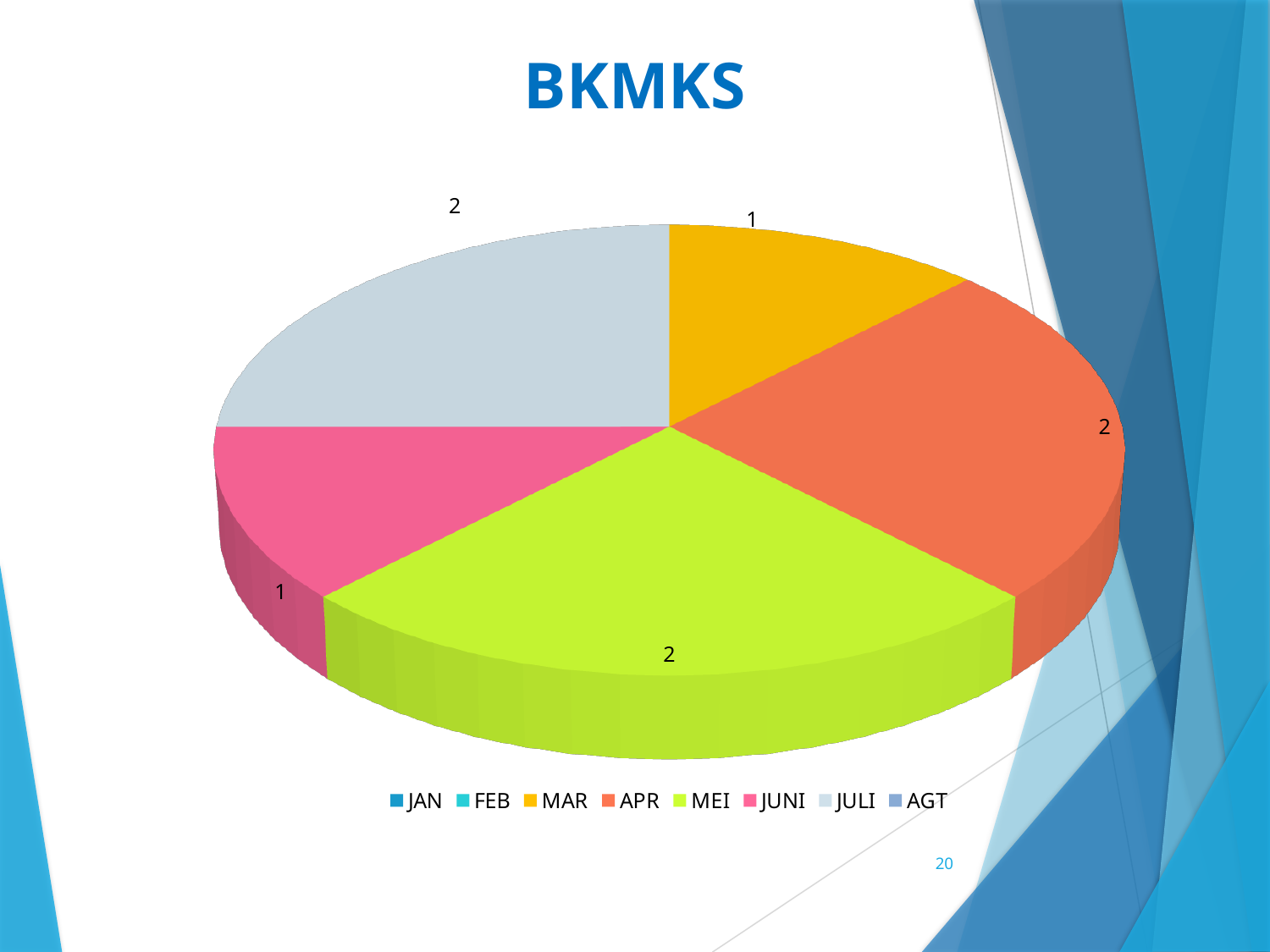
What is the value of the APR slice? 2 What is the value of the MEI slice? 2 What is the value of the JUNI slice? 1 What is the title of the chart? BKMKS What colour is the MEI slice? green What is the difference between the MEI value and the MAR value? 1 How many slices are visible in the pie chart? 5 Which is larger, the APR slice or the JUNI slice? APR What kind of chart is shown on the slide? pie chart What is the value of the MAR slice? 1 How many entries does the chart legend list? 8 What is the value of the JULI slice? 2